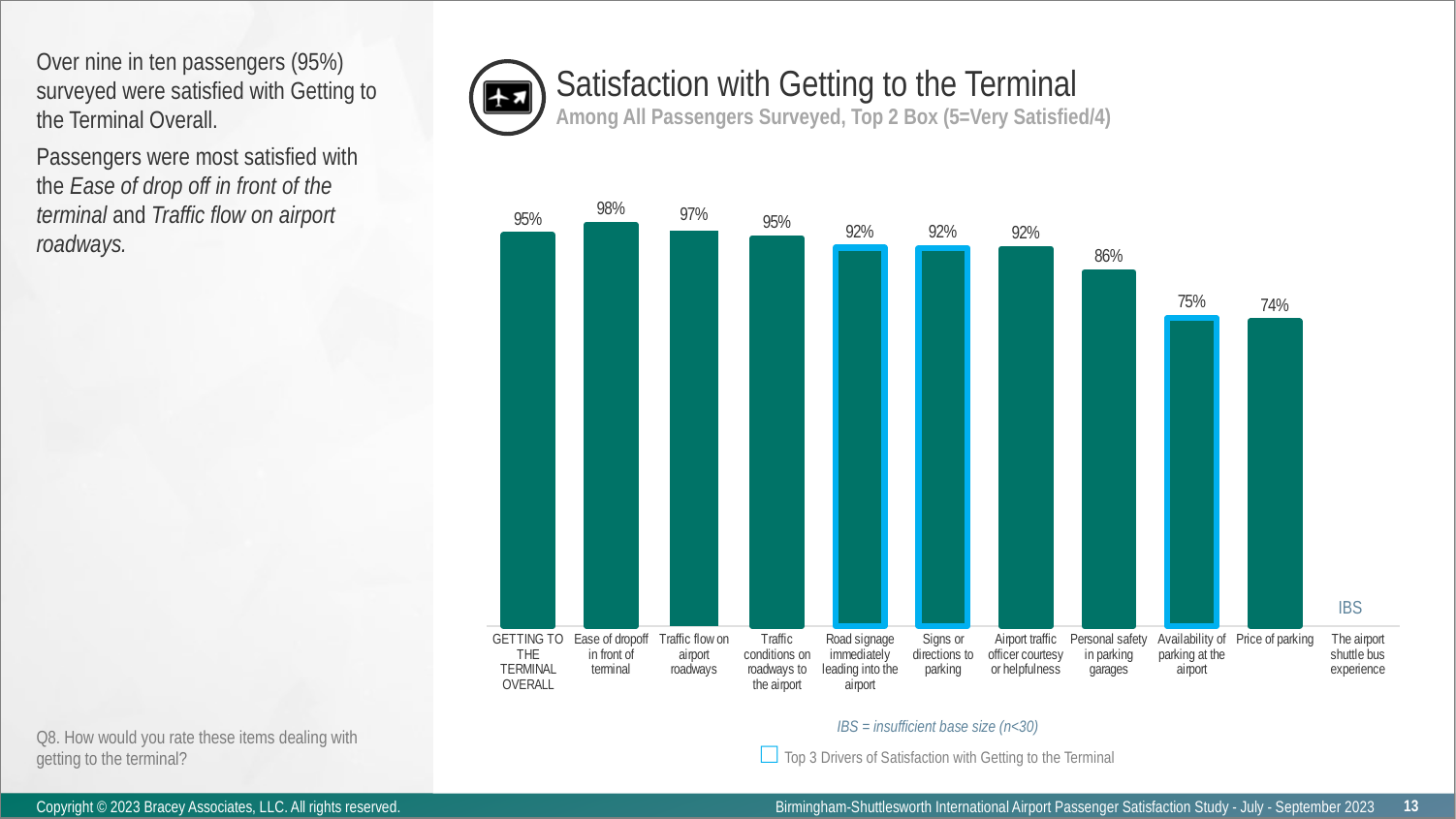
What is the satisfaction value for Price of parking? 74% What is the satisfaction value for GETTING TO THE TERMINAL OVERALL? 95% What is the title of the chart? Satisfaction with Getting to the Terminal What is the satisfaction value for Personal safety in parking garages? 86% What kind of chart is shown on the slide? Bar chart How many categories are listed along the x axis of the chart? 11 What is the difference between the satisfaction values for Traffic flow on airport roadways and Availability of parking at the airport? 22% What label is shown in place of a bar for The airport shuttle bus experience? IBS Among the categories with a plotted bar, which has the lowest satisfaction value? Price of parking Which category has the highest satisfaction value? Ease of dropoff in front of terminal Which is larger, the value for Personal safety in parking garages or the value for Availability of parking at the airport? Personal safety in parking garages What is the satisfaction value for Ease of dropoff in front of terminal? 98%